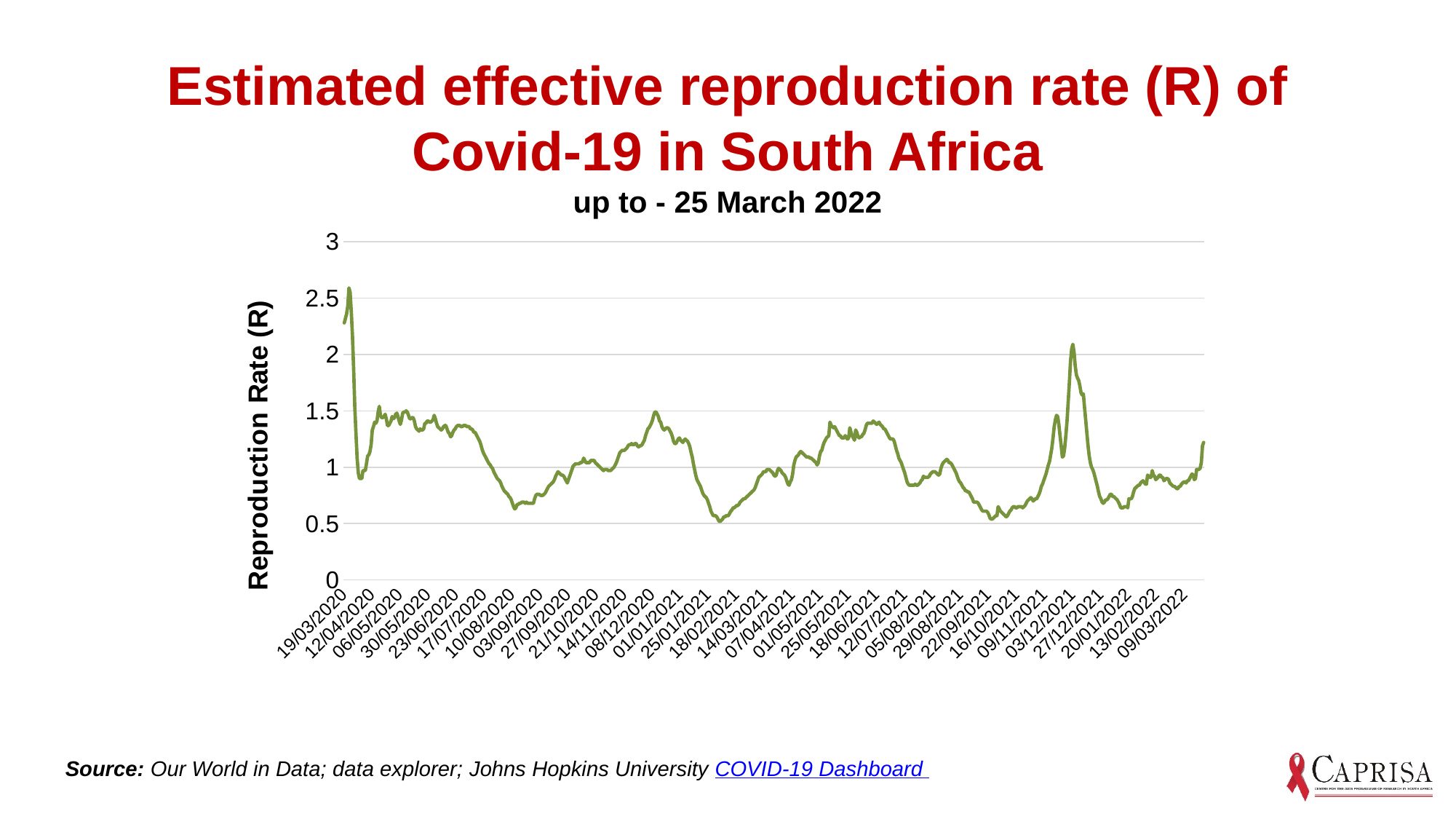
Does the reproduction rate rise or fall between 19/03/2020 and 12/04/2020? Falls Does the reproduction rate rise or fall between 18/02/2021 and 25/05/2021? Rises Is the reproduction rate around 22/09/2021 greater or less than 1? less What kind of chart is shown on the slide? Line chart Is the reproduction rate around 08/12/2020 greater or less than 1? greater Is the reproduction rate around 10/08/2020 greater or less than 1? less What is the highest value shown on the vertical axis of the chart? 3 What is the label on the vertical axis of the chart? Reproduction Rate (R) Up to what date does the chart's subtitle say the data runs? 25 March 2022